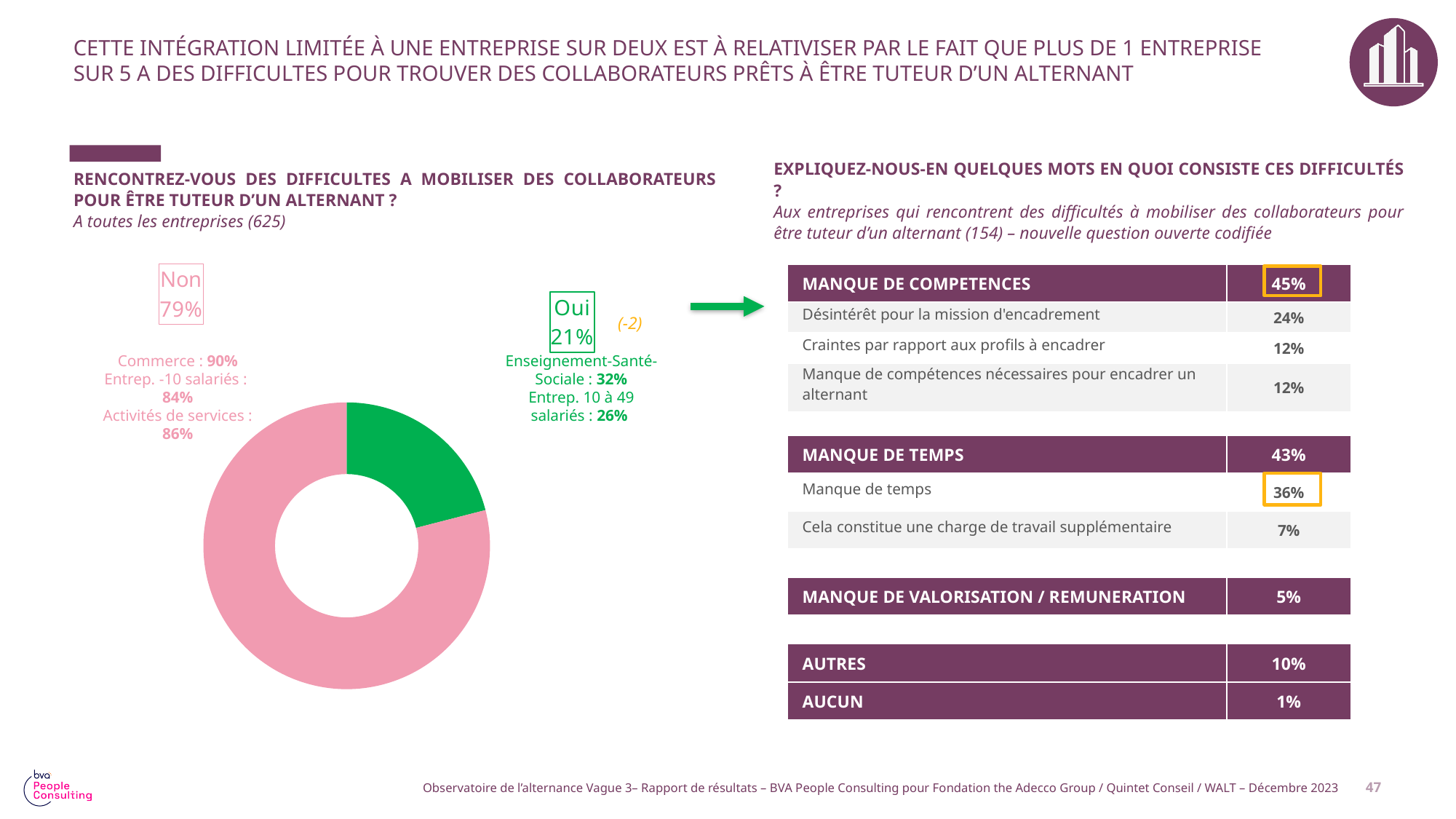
What type of chart is used to show the answers to the question about difficulties mobilising tutors? Donut (pie) chart What share of the donut chart does the "Oui" slice represent? 21% What colour is the "Oui" slice in the donut chart? Green In the donut chart, what percentage of companies answered "Oui"? 21% By how many percentage points does "Non" exceed "Oui" in the donut chart? 58 percentage points Which response has the largest slice in the donut chart? Non In the donut chart, which is larger: the "Oui" slice or the "Non" slice? Non In the donut chart, what percentage of companies answered "Non"? 79% How many slices does the donut chart have? 2 What is the total of the two slices shown in the donut chart? 100% Which response has the smallest slice in the donut chart? Oui What colour is the "Non" slice in the donut chart? Pink